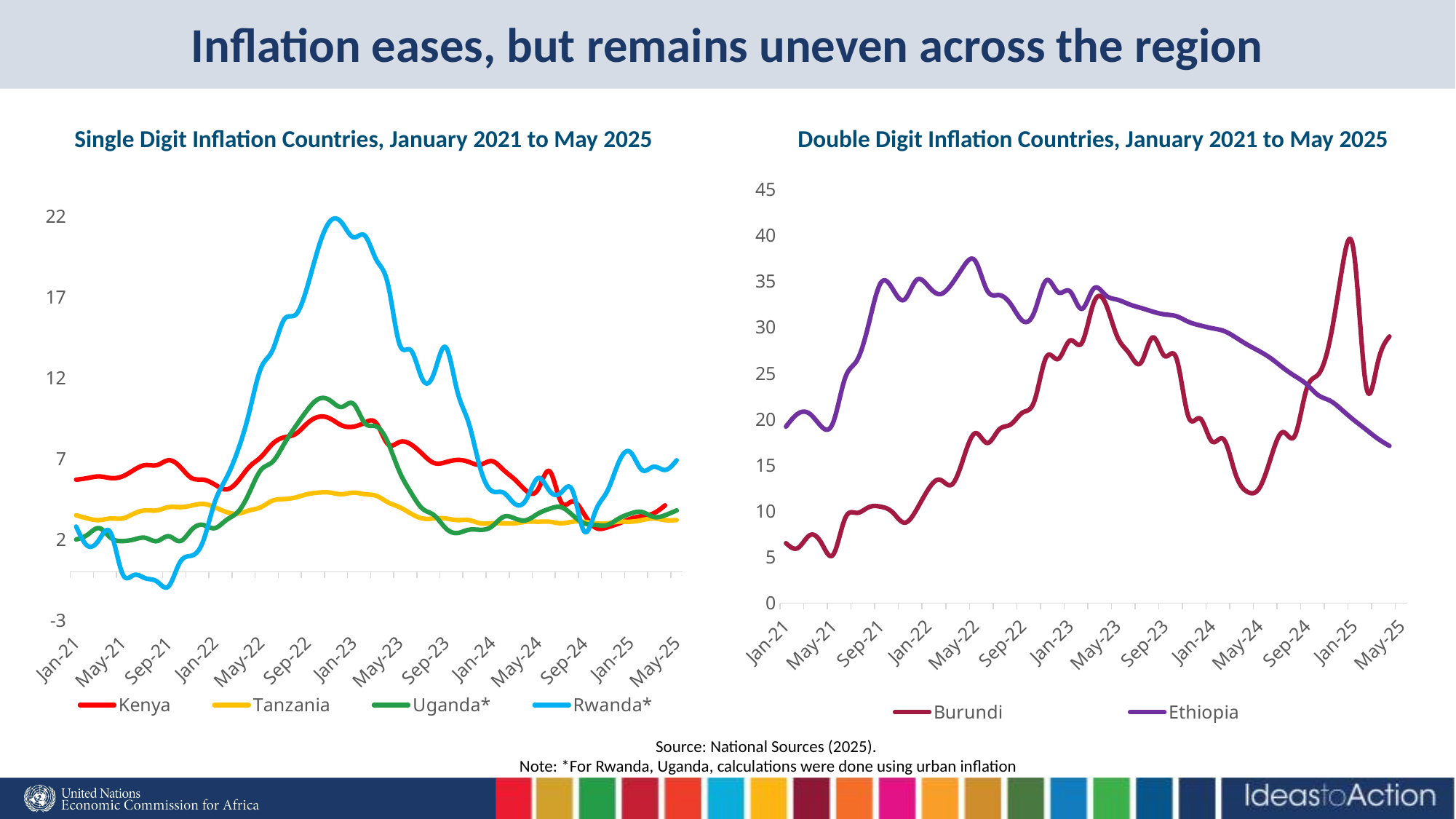
In the 'Double Digit Inflation Countries' chart, does the Ethiopia series rise or fall from May-22 to May-25? fall In the 'Double Digit Inflation Countries' chart, is the value for Burundi in Jan-21 greater or less than 10? less What colour is the Kenya line in the 'Single Digit Inflation Countries' chart? red How many series does the legend of the 'Double Digit Inflation Countries' chart list? 2 In the 'Single Digit Inflation Countries' chart, is the value for Tanzania in Jan-23 greater or less than 7? less What type of chart is the 'Single Digit Inflation Countries' chart? line chart In the 'Double Digit Inflation Countries' chart, which series has the higher value in Jan-22, Burundi or Ethiopia? Ethiopia In the 'Single Digit Inflation Countries' chart, is the peak value for Rwanda* greater or less than 17? greater In the 'Single Digit Inflation Countries' chart, which series reaches the highest value? Rwanda* How many series does the legend of the 'Single Digit Inflation Countries' chart list? 4